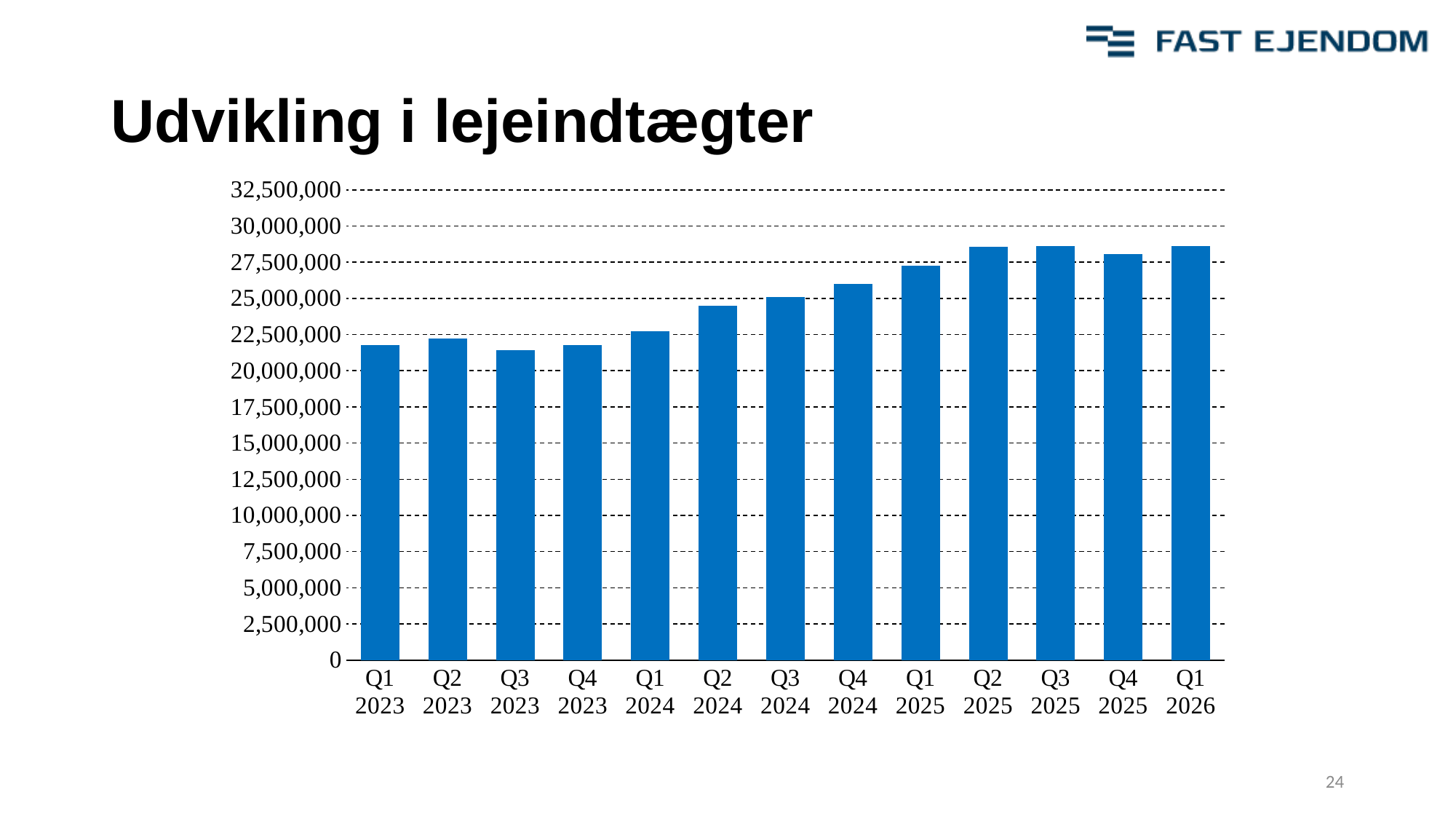
What is the title of the chart? Udvikling i lejeindtægter Which is larger, the value for Q1 2025 or the value for Q2 2025? Q2 2025 Is the value for Q3 2023 greater or less than 22,500,000? less Which is larger, the value for Q1 2023 or the value for Q4 2024? Q4 2024 Is the value for Q1 2026 greater or less than 27,500,000? greater Do the values generally rise or fall from Q1 2023 to Q1 2026? rise Which quarter has the lowest value in the chart? Q3 2023 Is the value for Q4 2025 greater or less than 27,500,000? greater What kind of chart is shown on the slide? bar chart How many quarters (bars) are plotted in the chart? 13